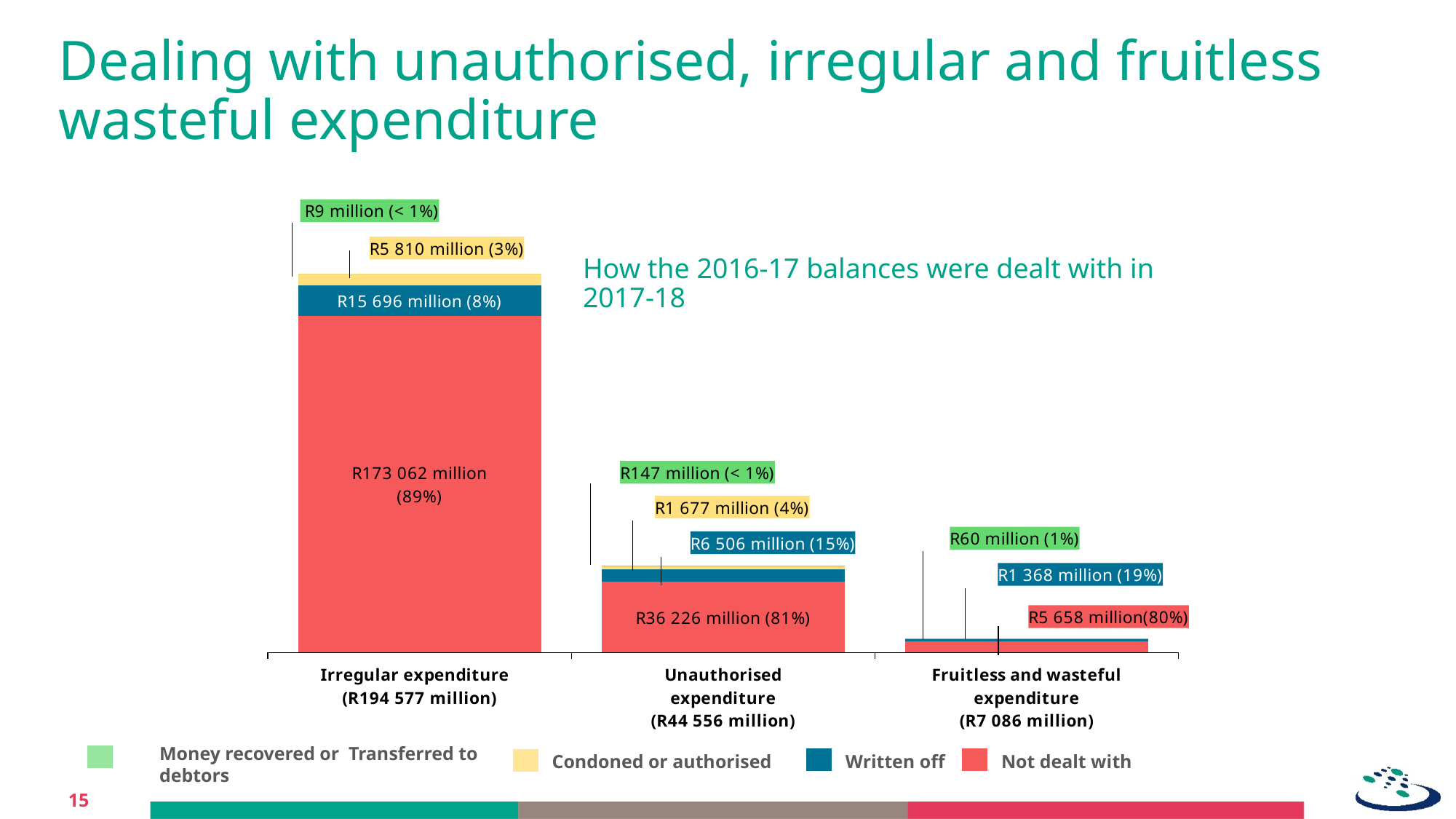
What is the 'Not dealt with' value for Irregular expenditure? R173 062 million (89%) What is the 'Money recovered or Transferred to debtors' value for Fruitless and wasteful expenditure? R60 million (1%) What is the total balance shown for Unauthorised expenditure? R44 556 million What kind of chart is shown on the slide? Stacked bar chart Which expenditure category has the largest total balance? Irregular expenditure What is the 'Condoned or authorised' value for Irregular expenditure? R5 810 million (3%) Which is larger: the 'Written off' amount for Irregular expenditure or for Unauthorised expenditure? Irregular expenditure What is the difference between the 'Not dealt with' amounts for Unauthorised expenditure and Fruitless and wasteful expenditure? R30 568 million How many expenditure categories are shown on the x axis? 3 How many series does the legend list? 4 What is the 'Written off' value for Unauthorised expenditure? R6 506 million (15%) Which expenditure category has the smallest total balance? Fruitless and wasteful expenditure